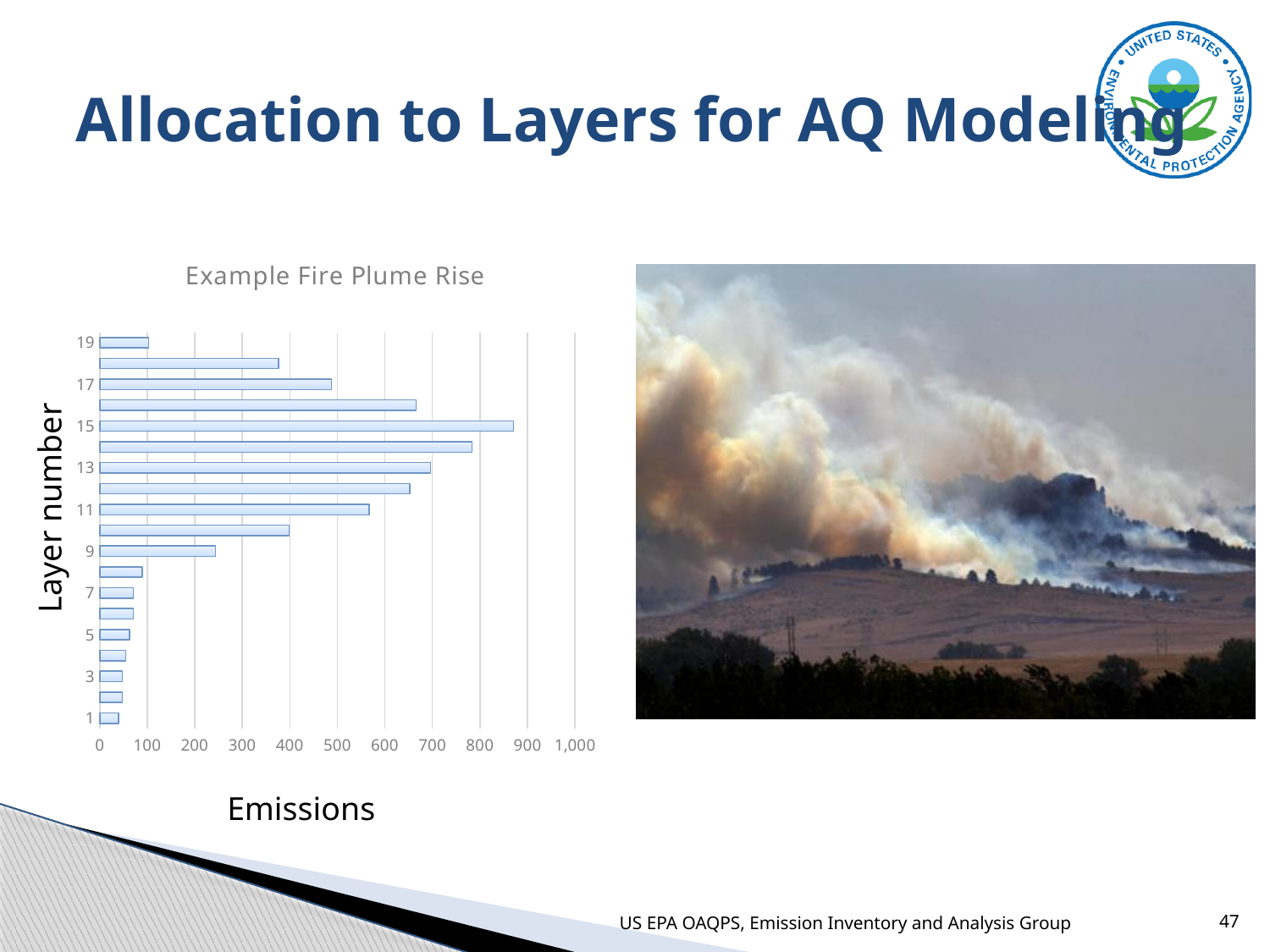
What kind of chart is shown on the slide? bar chart Is the emissions value for layer 13 greater or less than 600? greater Is the emissions value for layer 15 greater or less than 800? greater Is the emissions value for layer 9 greater or less than 200? greater What is the label of the vertical axis of the chart? Layer number Which has higher emissions, layer 18 or layer 19? layer 18 Which has higher emissions, layer 15 or layer 11? layer 15 How many layers (bars) are plotted in the chart? 19 What is the title of the chart? Example Fire Plume Rise Which layer number has the highest emissions? 15